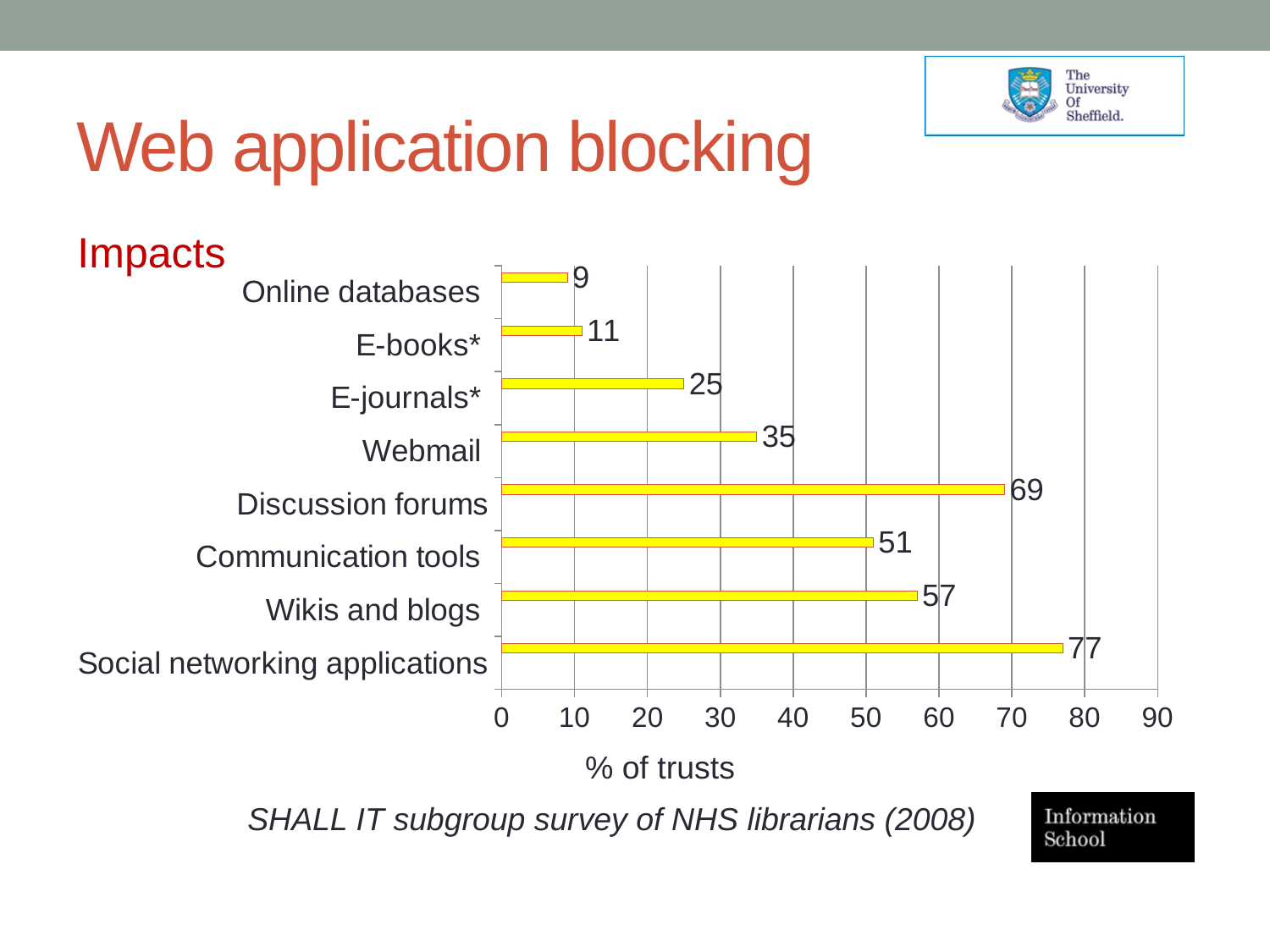
Which is larger, the value for Discussion forums or the value for Wikis and blogs? Discussion forums What is the difference between the values for Wikis and blogs and Communication tools? 6 Which category has the lowest value? Online databases What is the value for Discussion forums? 69 What is the difference between the values for E-journals* and E-books*? 14 What kind of chart is shown on the slide? Bar chart What is the value for Social networking applications? 77 Is the value for Communication tools greater or less than 40? greater How many categories are shown in the chart? 8 What is the value for Webmail? 35 Which category has the highest value? Social networking applications What is the label of the horizontal axis? % of trusts